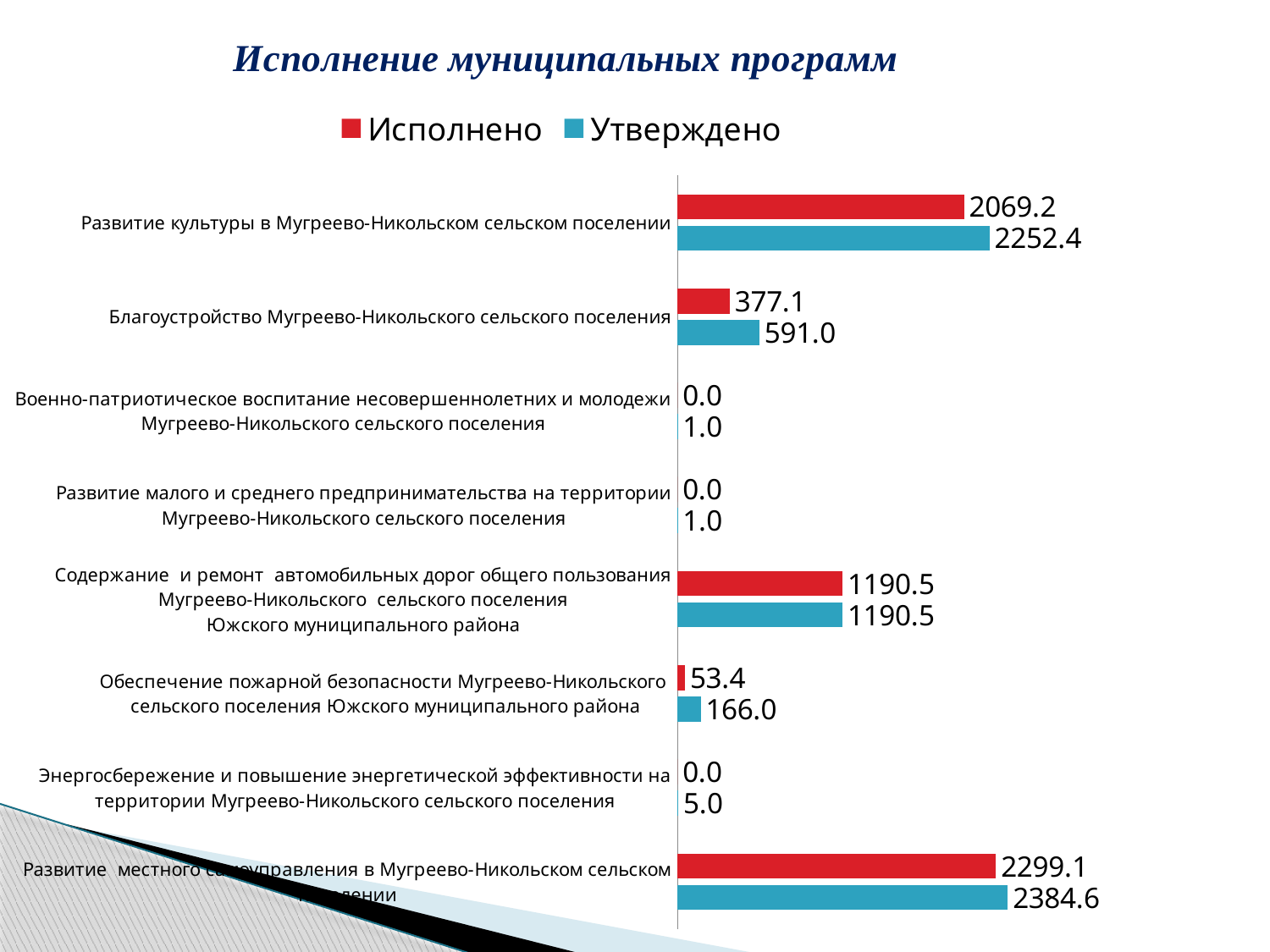
What is the Исполнено value for Содержание и ремонт автомобильных дорог общего пользования Мугреево-Никольского сельского поселения Южского муниципального района? 1190.5 Which is larger for Благоустройство Мугреево-Никольского сельского поселения: the Исполнено value or the Утверждено value? Утверждено What is the difference between the Утверждено and Исполнено values for Развитие культуры в Мугреево-Никольском сельском поселении? 183.2 What is the Утверждено value for Развитие культуры в Мугреево-Никольском сельском поселении? 2252.4 What type of chart is shown on the slide? bar chart What is the Утверждено value for Обеспечение пожарной безопасности Мугреево-Никольского сельского поселения Южского муниципального района? 166.0 How many series does the legend list? 2 Which programme has the highest Исполнено value? Развитие местного самоуправления в Мугреево-Никольском сельском поселении What is the Исполнено value for Благоустройство Мугреево-Никольского сельского поселения? 377.1 How many categories (municipal programmes) are shown in the chart? 8 Which programme has the highest Утверждено value? Развитие местного самоуправления в Мугреево-Никольском сельском поселении What colour are the Исполнено bars in the chart? red